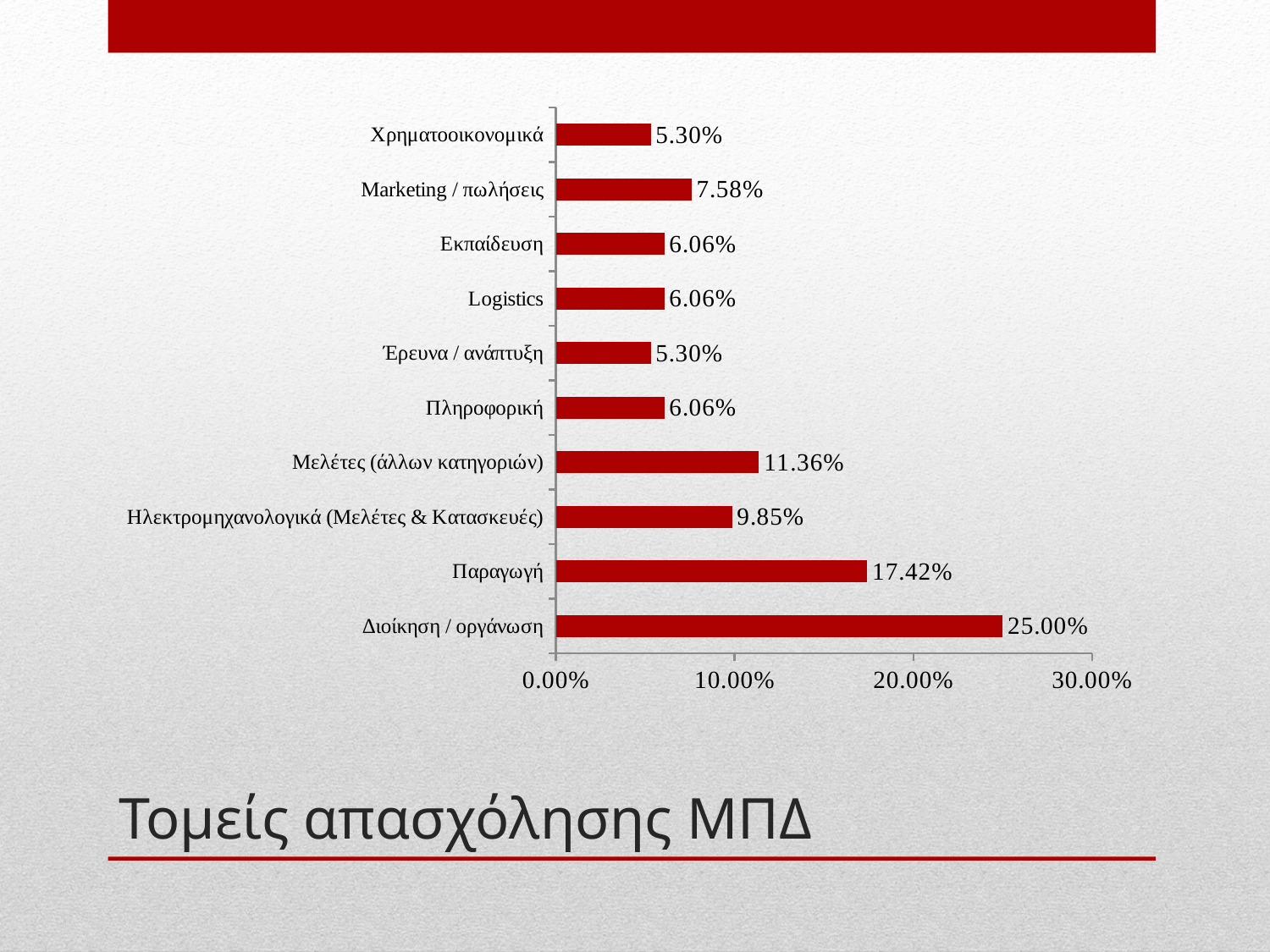
What is the value for Marketing / πωλήσεις? 7.58% What is the value for Μελέτες (άλλων κατηγοριών)? 11.36% What is the value for Logistics? 6.06% What is the value for Διοίκηση / οργάνωση? 25.00% Is the value for Παραγωγή greater or less than 20.00%? less What is the value for Παραγωγή? 17.42% Which is larger, the value for Ηλεκτρομηχανολογικά (Μελέτες & Κατασκευές) or the value for Μελέτες (άλλων κατηγοριών)? Μελέτες (άλλων κατηγοριών) Which category has the highest value? Διοίκηση / οργάνωση What is the difference between the values for Διοίκηση / οργάνωση and Παραγωγή? 7.58% What is the title of the slide? Τομείς απασχόλησης ΜΠΔ How many categories are shown in the chart? 10 What kind of chart is shown on the slide? bar chart